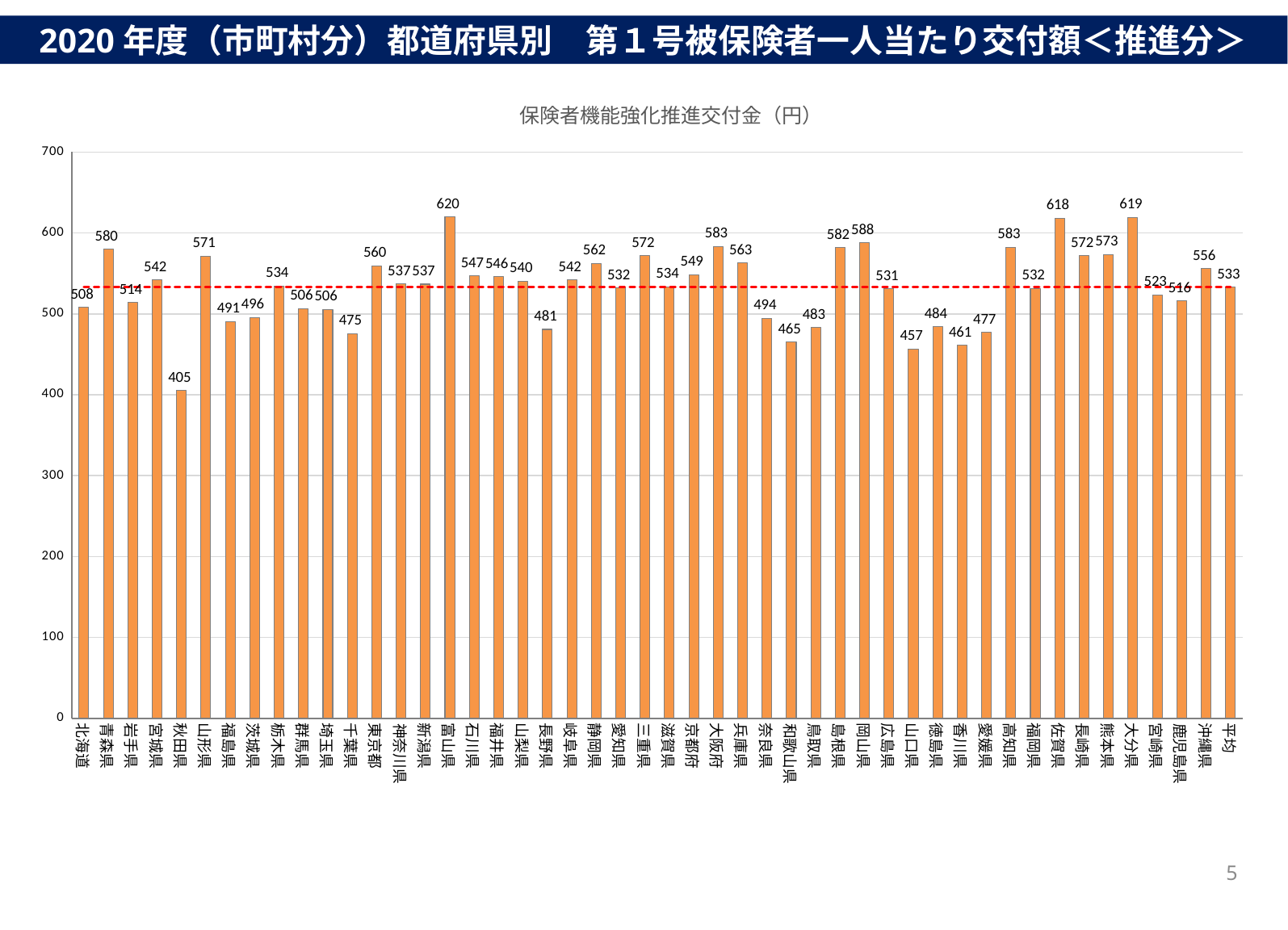
What kind of chart is shown on the slide? bar chart What is the value shown for 平均? 533 What is the difference between the values for 平均 and 北海道? 25 Which category has the lowest value? 秋田県 Which category has the highest value? 富山県 Which is larger, the value for 青森県 or the value for 岩手県? 青森県 What is the title of the chart? 保険者機能強化推進交付金（円） What is the value for 富山県? 620 Is the value for 山口県 greater or less than 500? less What is the value for 秋田県? 405 How many bars are plotted in the chart? 48 What is the difference between the values for 富山県 and 秋田県? 215